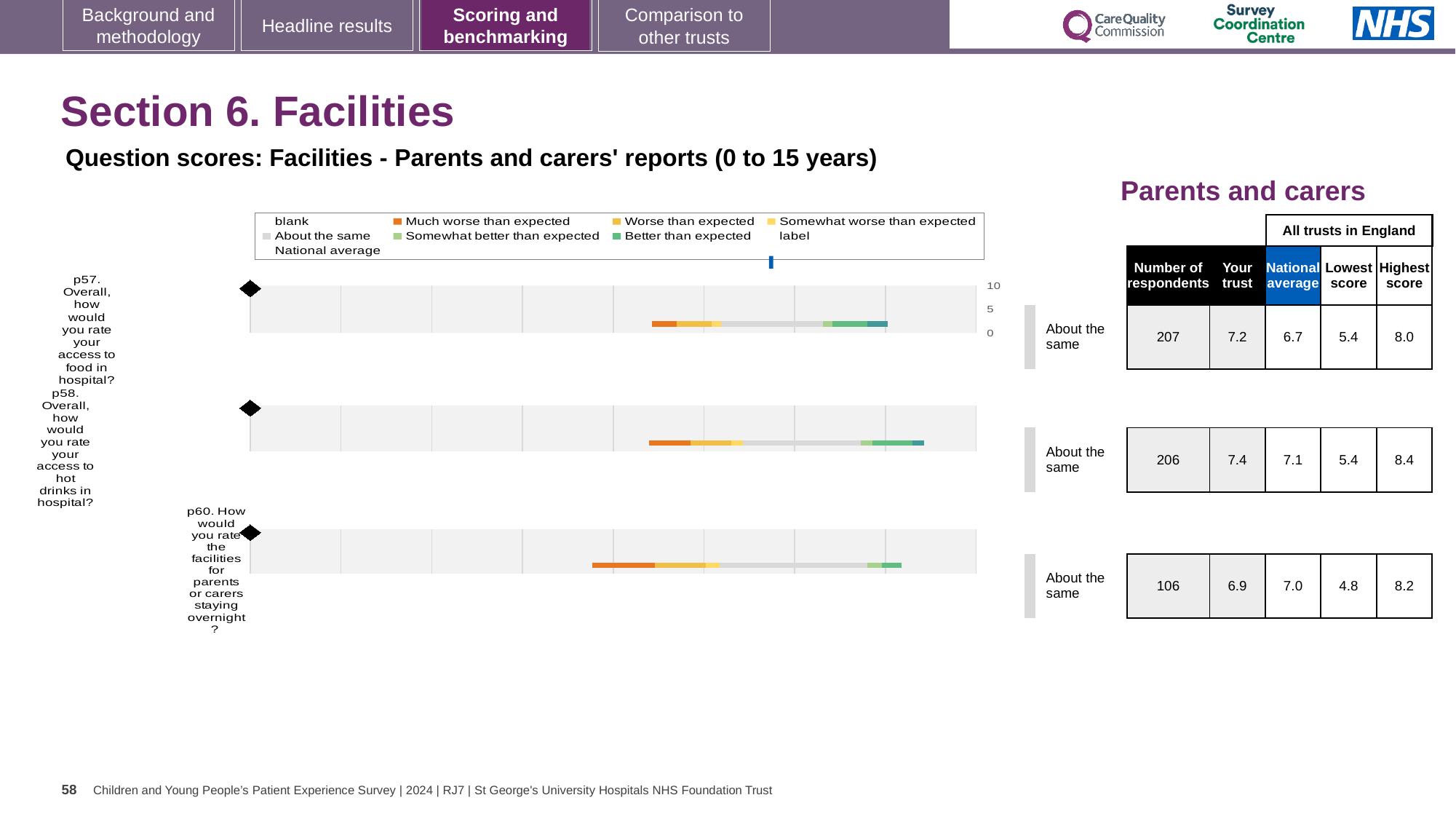
Which question has the highest 'Your trust' score? p58 In the chart legend, which colour represents 'Much worse than expected'? orange What kind of chart is used to show the benchmark results for each question? bar chart What is the 'Your trust' score for p57 (access to food in hospital)? 7.2 What is the national average score for p58 (access to hot drinks in hospital)? 7.1 For p58, what is the difference between the highest score and the lowest score across all trusts in England? 3.0 Is the 'Your trust' score for p60 greater or less than 5 on the chart axis? greater For p57, which is larger: the 'Your trust' score or the national average? Your trust What benchmark category is shown for p57? About the same How many questions are plotted on the slide's benchmark charts? 3 How many respondents answered p60 (facilities for parents or carers staying overnight)? 106 Which question has the lowest 'Your trust' score? p60